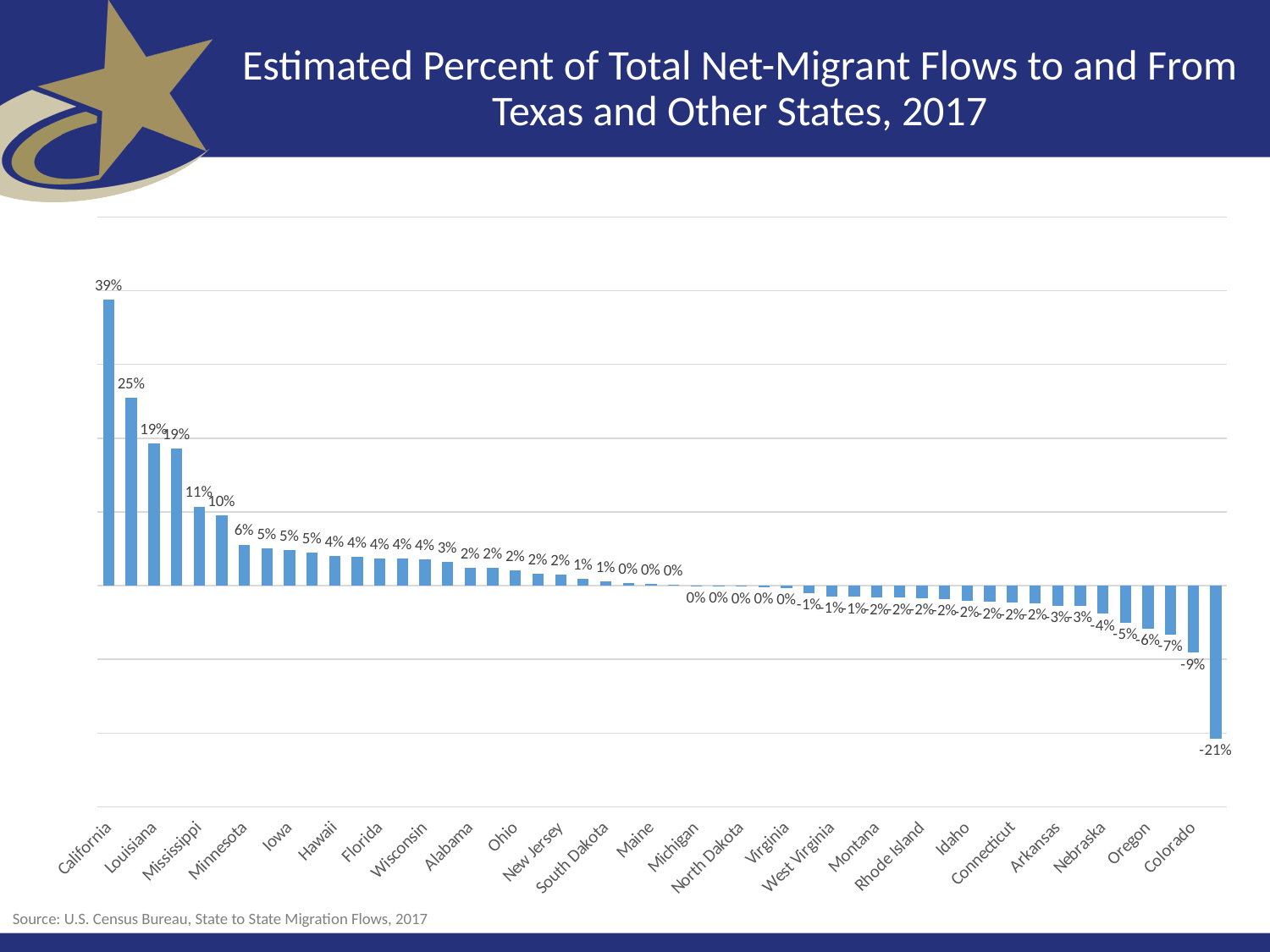
What is the title of the chart? Estimated Percent of Total Net-Migrant Flows to and From Texas and Other States, 2017 What type of chart is shown on the slide? Bar chart Do the values rise or fall moving from left to right along the x axis? Fall What is the value shown for Colorado? -9% What is the value shown for Louisiana? 19% What is the value shown for California? 39% What is the second-highest value labeled on the chart? 25% Which state has the highest estimated percent of total net-migrant flows? California What source is cited for the chart data? U.S. Census Bureau, State to State Migration Flows, 2017 Which is larger, the value for California or the value for Colorado? California